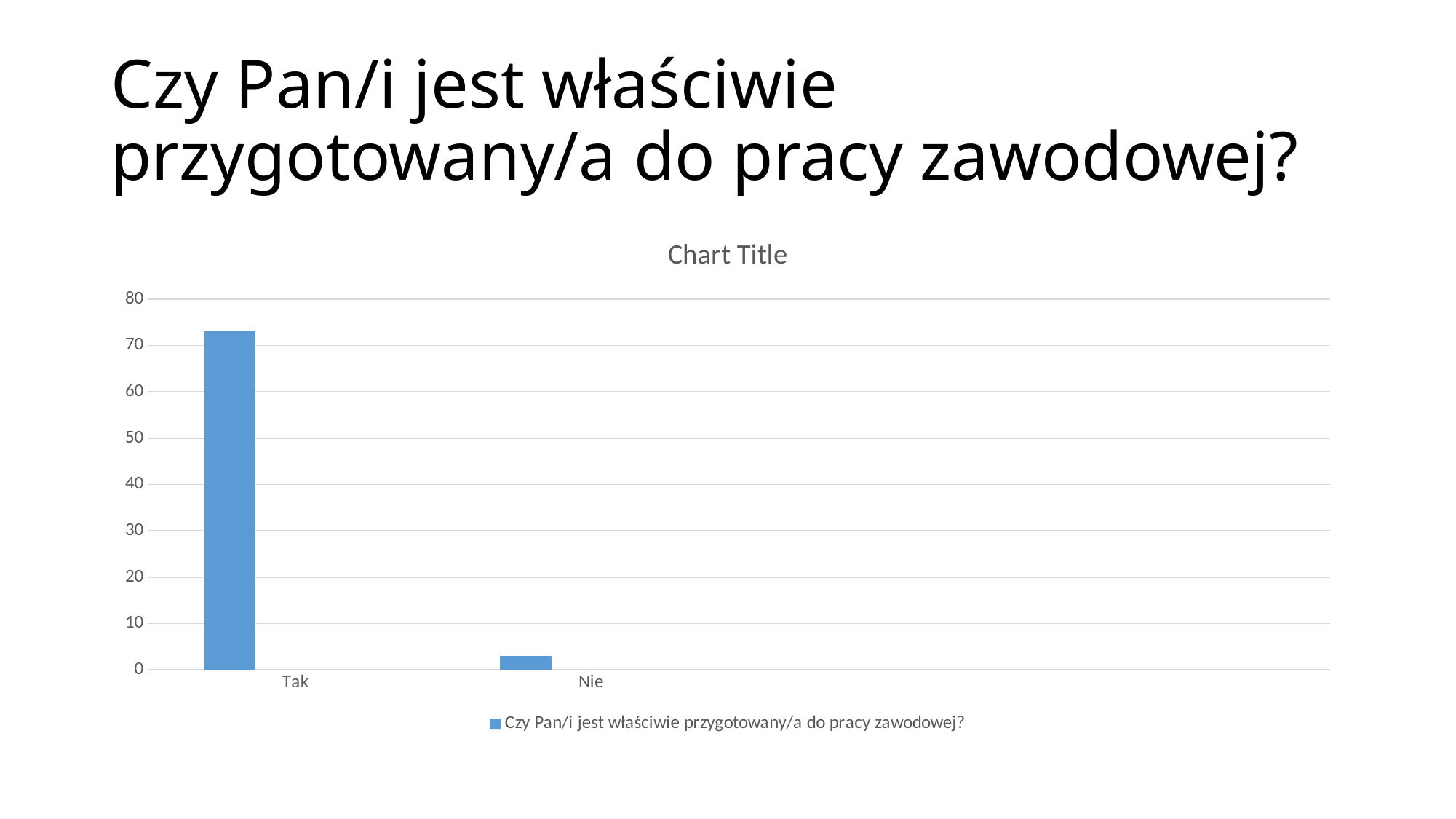
What is the highest value shown on the vertical axis of the chart? 80 Is the value for Tak greater or less than 80? less What is the legend entry of the chart? Czy Pan/i jest właściwie przygotowany/a do pracy zawodowej? What kind of chart is shown on the slide? bar chart What is the title shown above the chart? Chart Title Is the value for Tak greater or less than 60? greater Which category has the lowest value in the chart? Nie Is the value for Nie greater or less than 10? less Which has a larger value, Tak or Nie? Tak Which category has the highest value in the chart? Tak How many series does the chart legend list? 1 How many categories are shown on the x axis of the chart? 2